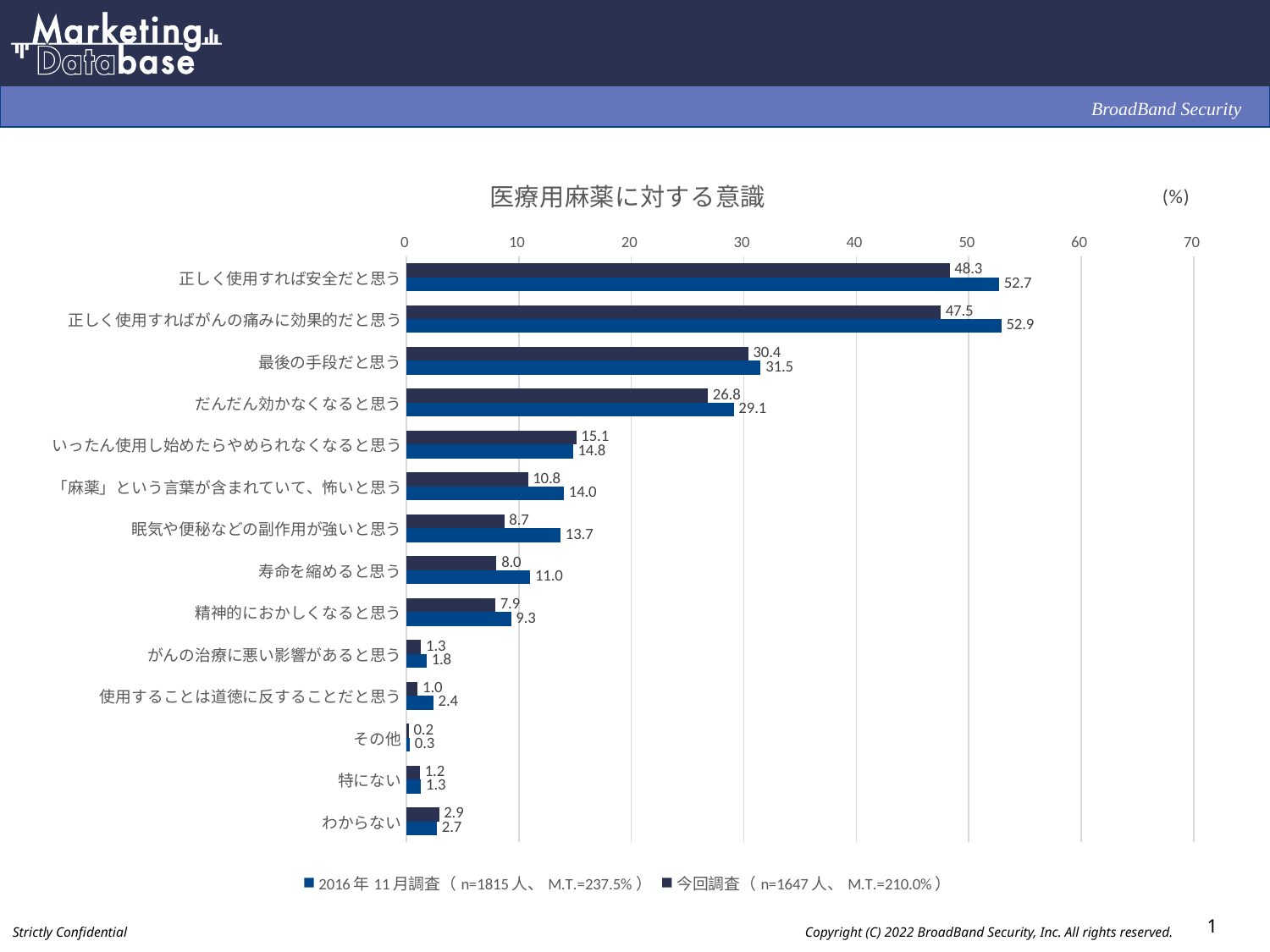
What is the value for 正しく使用すれば安全だと思う in the 今回調査 series? 48.3 What is the value for 正しく使用すればがんの痛みに効果的だと思う in the 2016年11月調査 series? 52.9 Which category has the highest value in the 今回調査 series? 正しく使用すれば安全だと思う What type of chart is shown on the slide? bar chart Which category has the lowest value in the 2016年11月調査 series? その他 What is the value for 眠気や便秘などの副作用が強いと思う in the 2016年11月調査 series? 13.7 What is the difference between the 2016年11月調査 and 今回調査 values for 寿命を縮めると思う? 3.0 For 「麻薬」という言葉が含まれていて、怖いと思う, which series has the larger value, 2016年11月調査 or 今回調査? 2016年11月調査 What is the title of the chart? 医療用麻薬に対する意識 Is the 今回調査 value for 最後の手段だと思う greater or less than 30? greater How many categories are plotted on the chart? 14 How many series does the legend list? 2